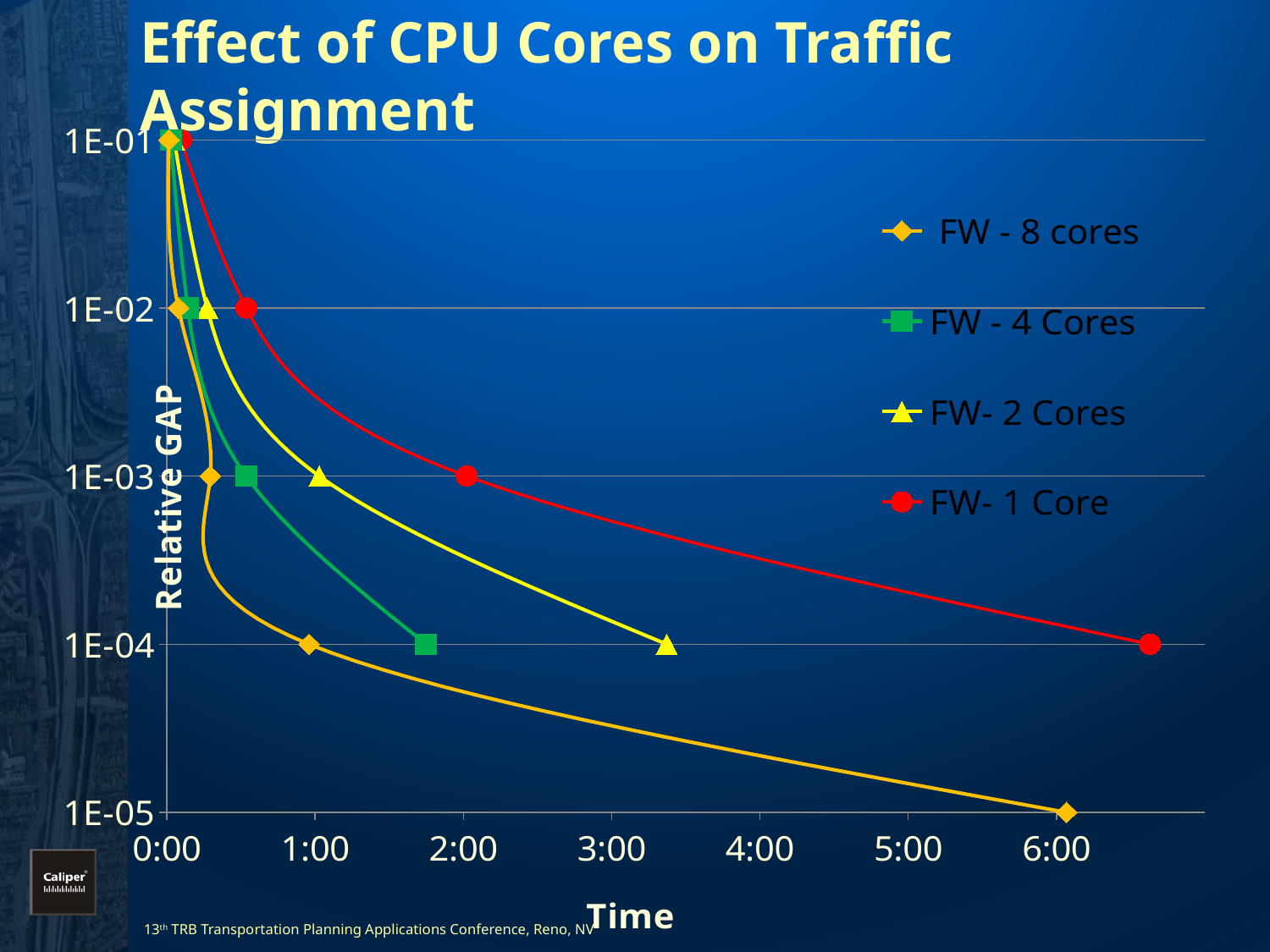
What is the title of the chart? Effect of CPU Cores on Traffic Assignment What kind of chart is shown on the slide? line chart How many series does the legend list? 4 Do the Relative GAP values rise or fall as Time increases? fall What is the label of the vertical axis? Relative GAP Which series takes the longest time to reach a Relative GAP of 1E-04? FW- 1 Core Is the time at which FW- 1 Core reaches a Relative GAP of 1E-04 greater or less than 6:00? greater Is the time at which FW- 2 Cores reaches a Relative GAP of 1E-04 greater or less than 4:00? less Which series reaches a Relative GAP of 1E-04 sooner, FW - 4 Cores or FW- 2 Cores? FW - 4 Cores What is the lowest Relative GAP reached by the FW- 1 Core series? 1E-04 What is the lowest Relative GAP reached by the FW - 8 cores series? 1E-05 Which series reaches the lowest Relative GAP on the chart? FW - 8 cores